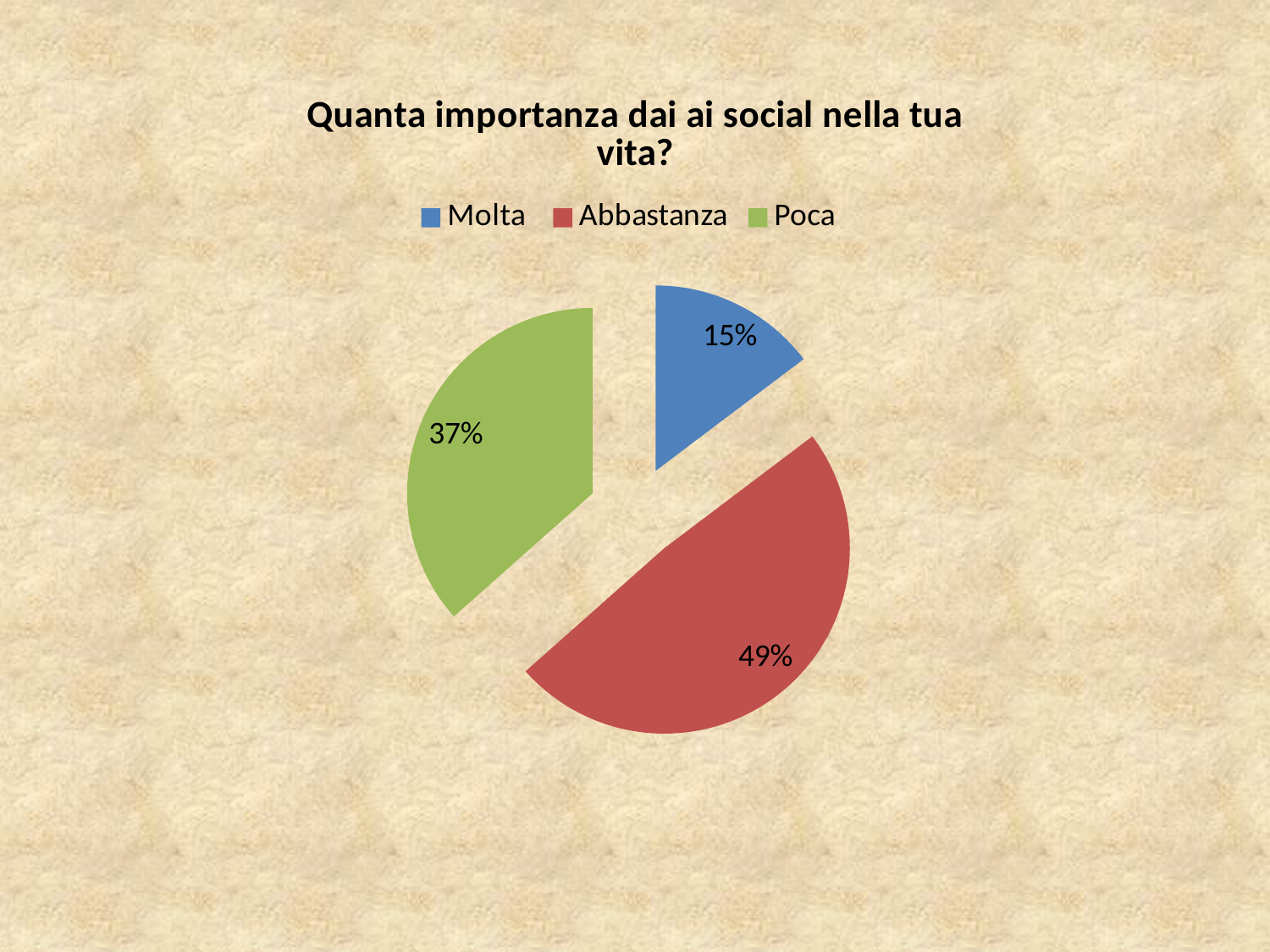
What percentage is shown for Molta? 15% Which category has the largest share of the pie? Abbastanza What is the difference in percentage points between Abbastanza and Poca? 12 How many slices does the pie chart have? 3 What colour is the slice for Poca? green Which category has the smallest share of the pie? Molta What kind of chart is shown on the slide? pie chart What percentage is shown for Abbastanza? 49% How many entries does the legend list? 3 What is the title of the chart? Quanta importanza dai ai social nella tua vita? Which is larger, the share for Poca or the share for Molta? Poca What percentage is shown for Poca? 37%